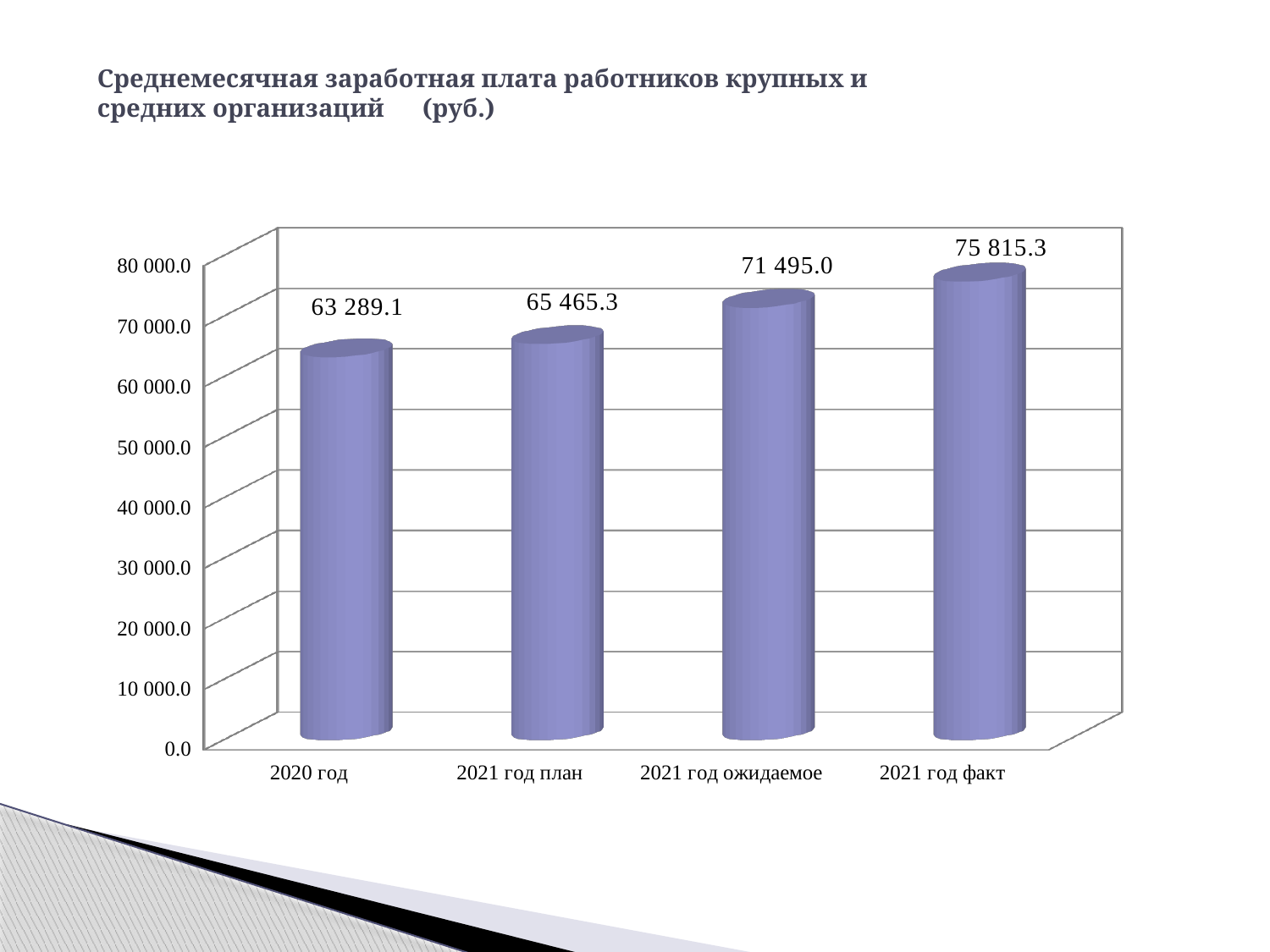
Do the values rise or fall from left to right along the x axis? rise Which category has the lowest value? 2020 год What is the value for 2021 год факт? 75 815.3 What is the value for 2021 год план? 65 465.3 How many categories are shown on the x axis? 4 What kind of chart is shown on the slide? bar chart Which category has the highest value? 2021 год факт What is the value for 2021 год ожидаемое? 71 495.0 What is the difference between the values for 2021 год факт and 2020 год? 12 526.2 What is the value for 2020 год? 63 289.1 What is the difference between the values for 2021 год ожидаемое and 2021 год план? 6 029.7 Which is larger, the value for 2021 год план or the value for 2021 год ожидаемое? 2021 год ожидаемое